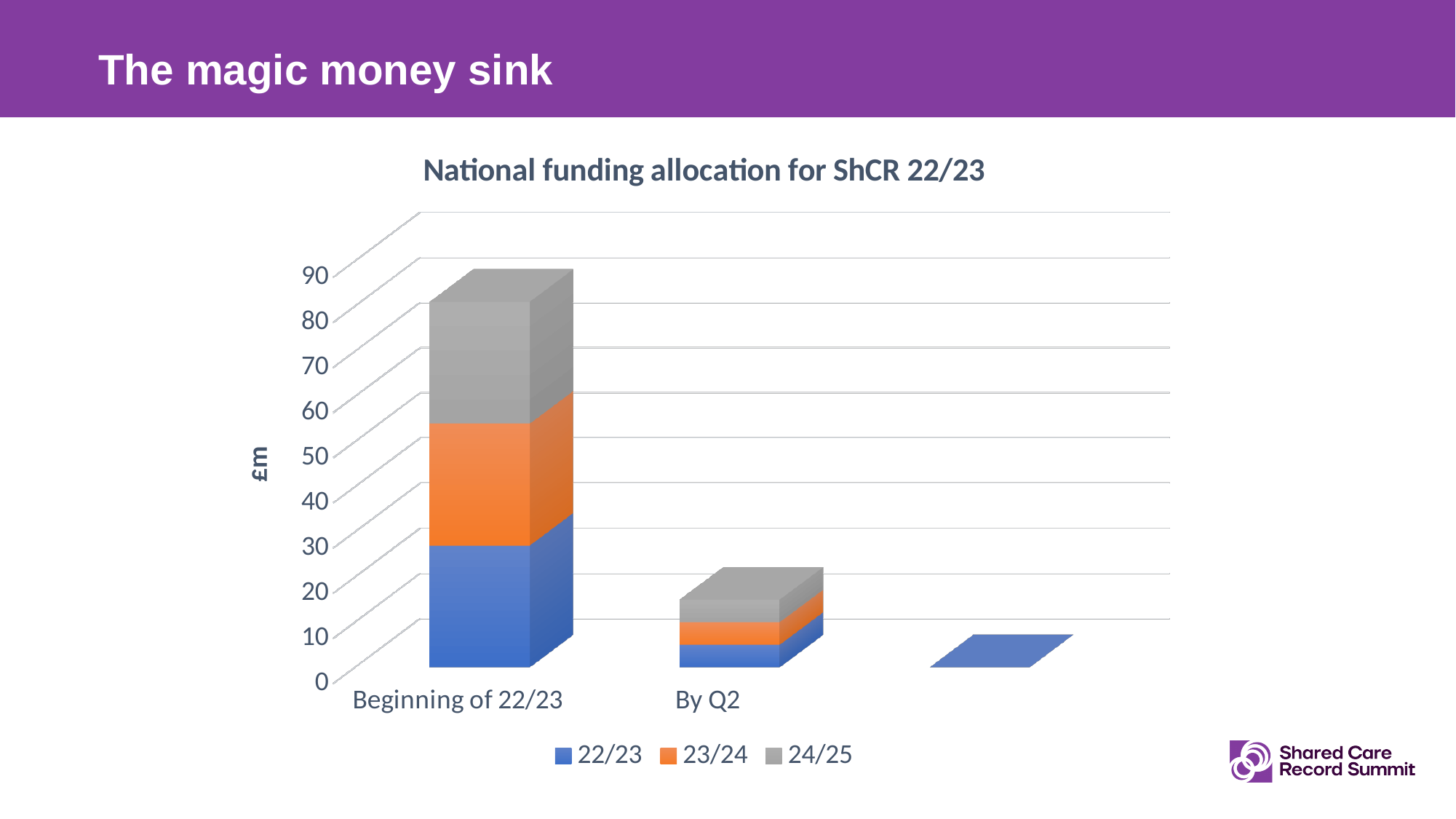
Which is larger, the total for Beginning of 22/23 or the total for By Q2? Beginning of 22/23 Which labelled category has the highest total funding allocation? Beginning of 22/23 Is the total value for By Q2 greater or less than 30? less What is the label on the vertical axis? £m Is the total value for Beginning of 22/23 greater or less than 60? greater Which series is shown in grey in the legend? 24/25 What kind of chart is shown on the slide? Stacked bar chart How many series does the legend list? 3 Do the total values rise or fall moving from left to right along the x axis? fall What is the title of the chart? National funding allocation for ShCR 22/23 Is the 22/23 segment for Beginning of 22/23 greater or less than 20? greater